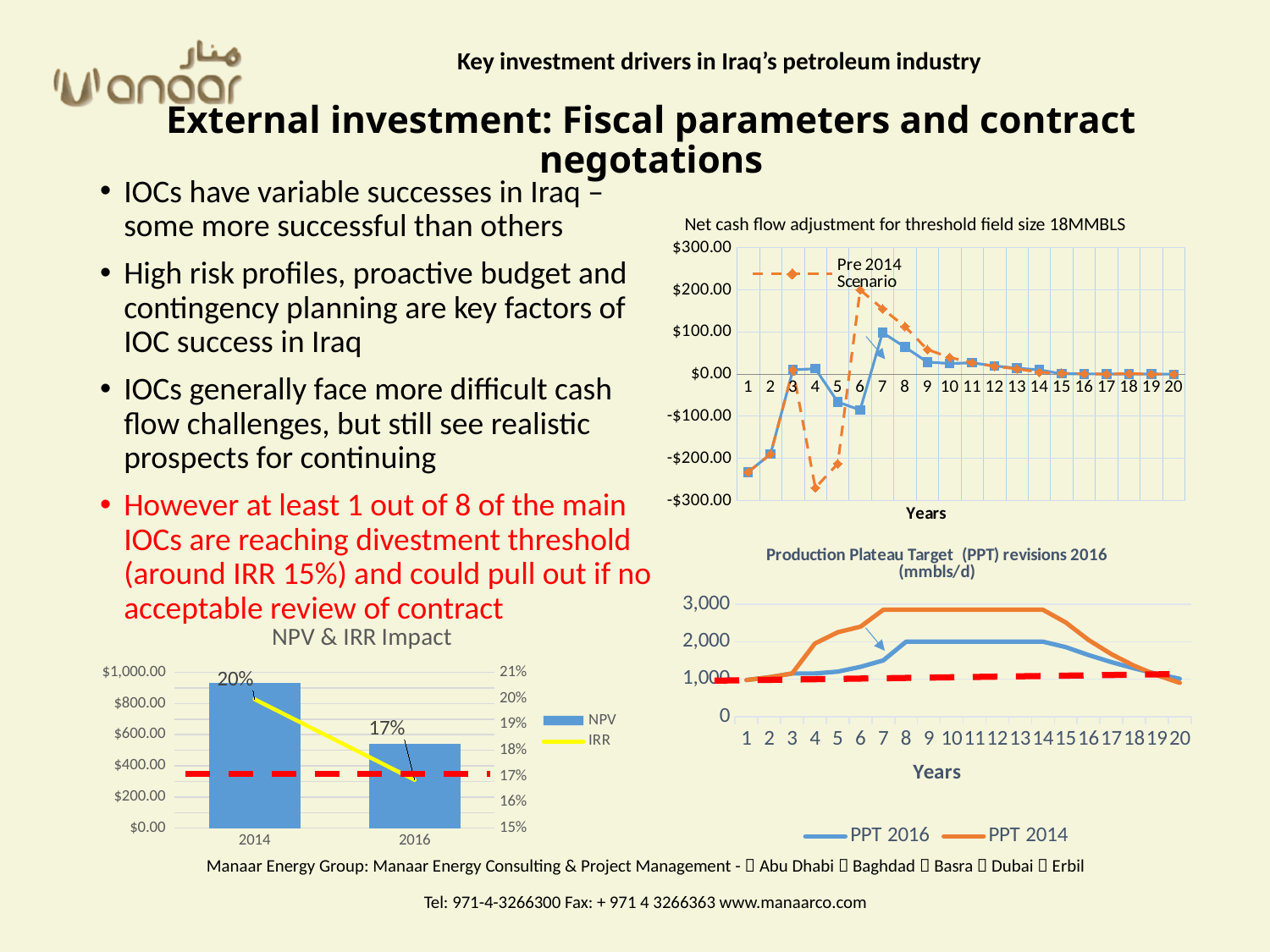
In the NPV & IRR Impact chart, how many years are shown on the x axis? 2 In the Production Plateau Target (PPT) revisions 2016 chart, which series is higher at year 10, PPT 2016 or PPT 2014? PPT 2014 In the NPV & IRR Impact chart, is the NPV for 2014 greater or less than $800.00? greater In the NPV & IRR Impact chart, how many series does the legend list? 2 In the Net cash flow adjustment chart, how many years are plotted along the x axis? 20 In the NPV & IRR Impact chart, what is the IRR for 2014? 20% In the Net cash flow adjustment chart, is the Pre 2014 Scenario value at year 6 greater or less than $100.00? greater In the NPV & IRR Impact chart, by how many percentage points does the IRR fall from 2014 to 2016? 3 percentage points In the NPV & IRR Impact chart, is the NPV for 2016 greater or less than $600.00? less In the NPV & IRR Impact chart, which year has the higher NPV, 2014 or 2016? 2014 What kind of chart is the Production Plateau Target (PPT) revisions 2016 chart? line chart In the NPV & IRR Impact chart, what is the IRR for 2016? 17%